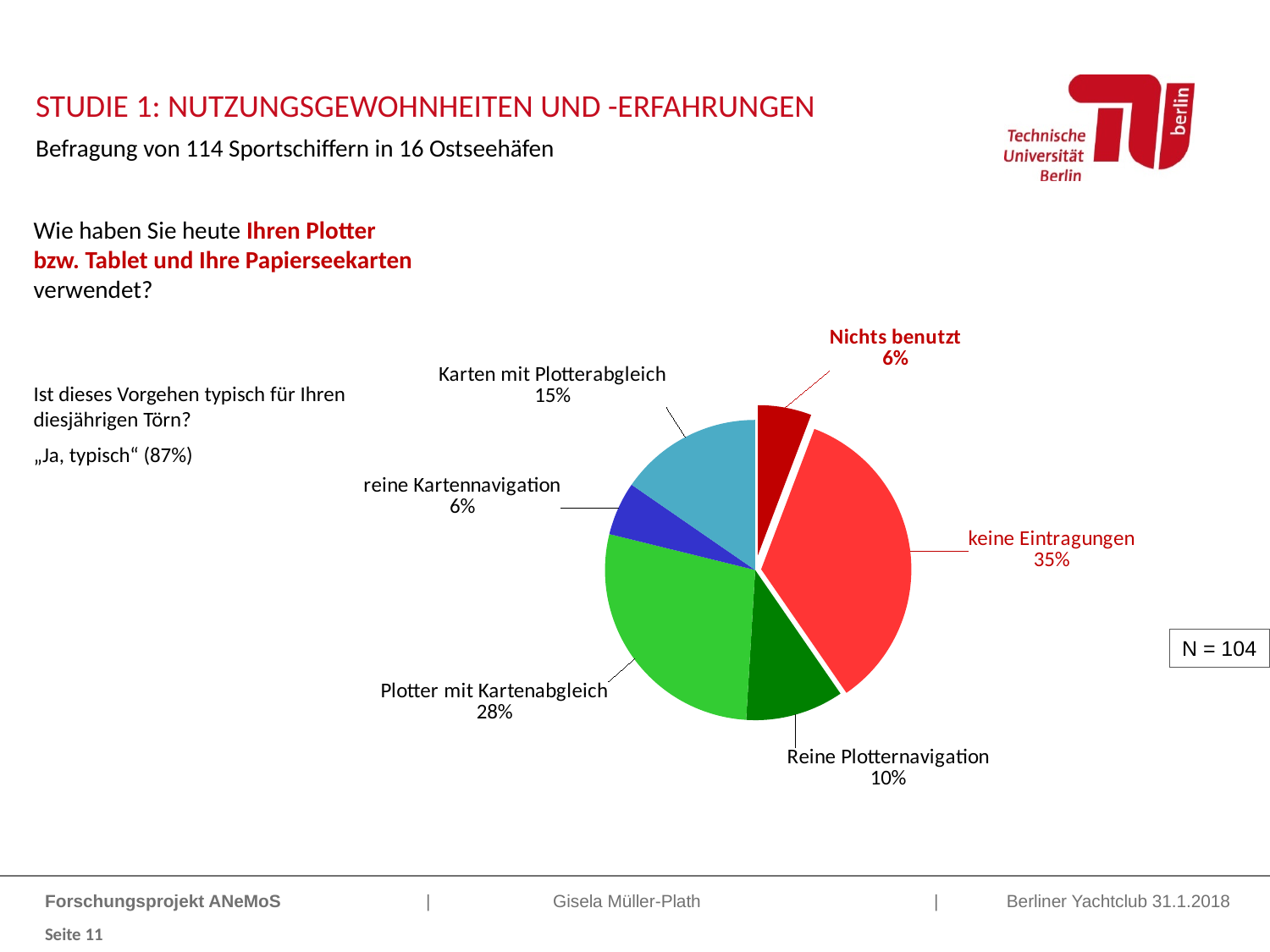
How many slices does the pie chart have? 6 What percentage is shown for "Nichts benutzt"? 6% What is the difference in percentage points between "keine Eintragungen" and "Plotter mit Kartenabgleich"? 7 percentage points What percentage is shown for "Plotter mit Kartenabgleich"? 28% Which category has the largest share of the pie? keine Eintragungen What percentage is shown for "Karten mit Plotterabgleich"? 15% Which is larger, the share for "Karten mit Plotterabgleich" or the share for "Reine Plotternavigation"? Karten mit Plotterabgleich What share of the pie does "keine Eintragungen" represent? 35% What percentage is shown for "Reine Plotternavigation"? 10% What is the combined share of "reine Kartennavigation" and "Karten mit Plotterabgleich"? 21% What kind of chart is shown on the slide? Pie chart What sample size (N) is stated next to the pie chart? N = 104